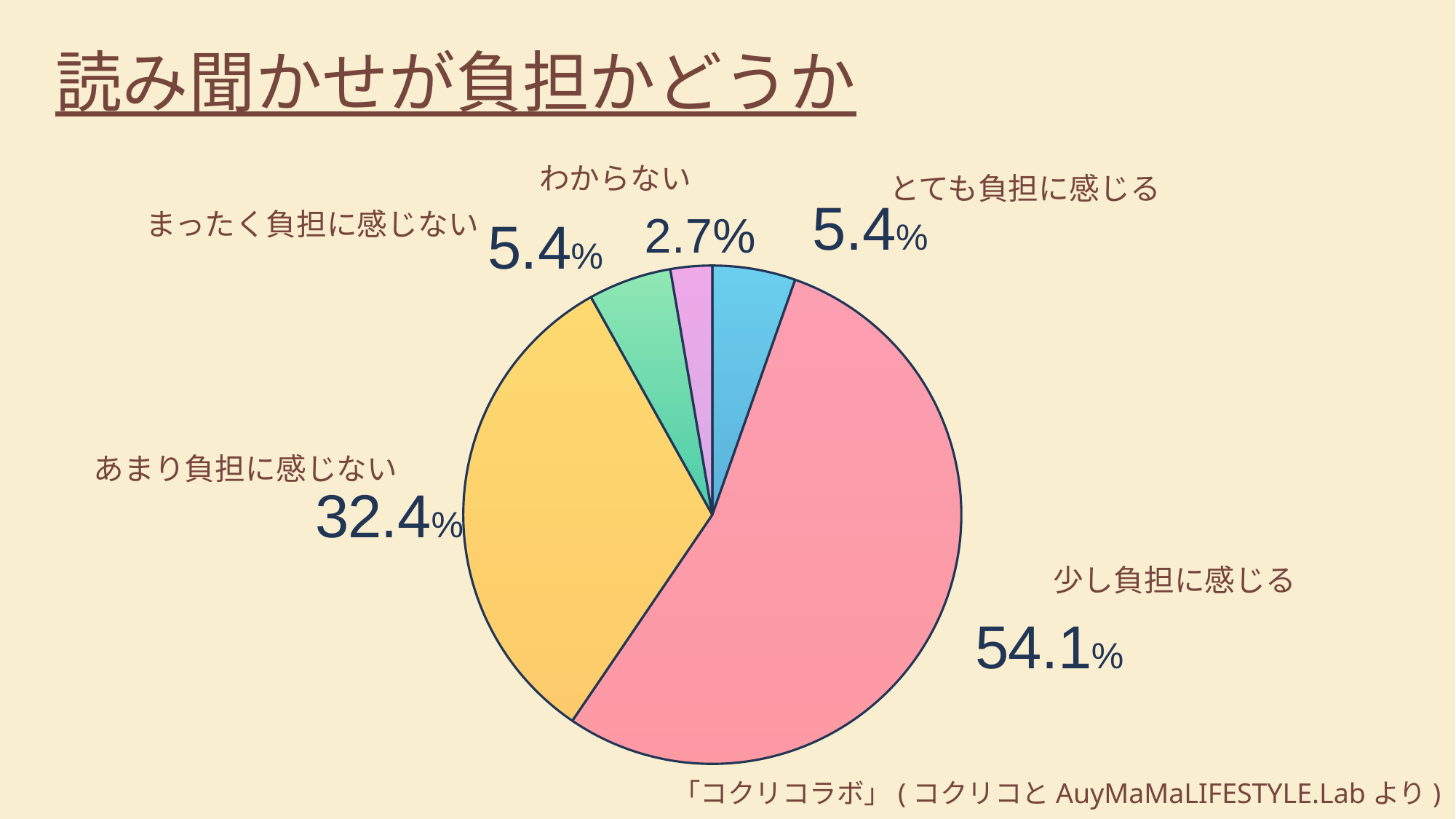
Which category has the largest share of the pie? 少し負担に感じる Which category has the smallest share of the pie? わからない What percentage is shown for 少し負担に感じる? 54.1% What percentage is shown for わからない? 2.7% What percentage is shown for あまり負担に感じない? 32.4% How many slices does the pie chart have? 5 What colour is the slice for 少し負担に感じる? Pink What is the difference in percentage points between 少し負担に感じる and あまり負担に感じない? 21.7% What is the title of the chart on the slide? 読み聞かせが負担かどうか What kind of chart is shown on the slide? Pie chart What percentage is shown for とても負担に感じる? 5.4% Which is larger, the share for まったく負担に感じない or the share for わからない? まったく負担に感じない